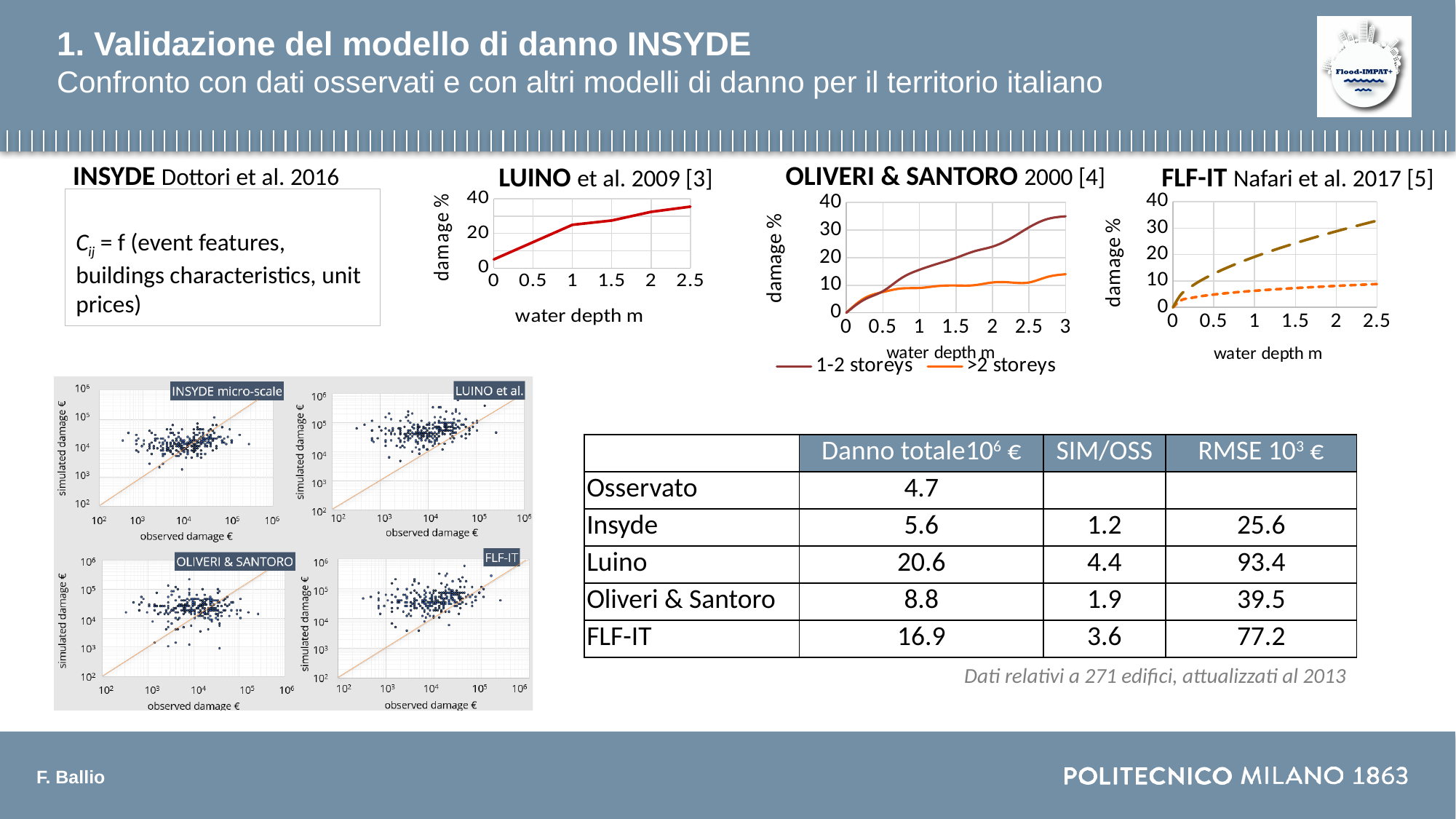
In the LUINO et al. 2009 chart, is the damage % at a water depth of 2.5 m greater or less than 30? greater In the OLIVERI & SANTORO 2000 chart, is the damage % for 1-2 storeys at a water depth of 3 m greater or less than 30? greater In the FLF-IT Nafari et al. 2017 chart, is the lower dashed line at a water depth of 2.5 m greater or less than 20 damage %? less How many series does the legend of the OLIVERI & SANTORO 2000 chart list? 2 In the OLIVERI & SANTORO 2000 chart, which series has the higher damage % at a water depth of 3 m? 1-2 storeys What are the two series named in the legend of the OLIVERI & SANTORO 2000 chart? 1-2 storeys and >2 storeys In the LUINO et al. 2009 chart, does damage % rise or fall as water depth increases? rise What kind of chart is the LUINO et al. 2009 chart? line chart What is the label of the x axis of the FLF-IT Nafari et al. 2017 chart? water depth m